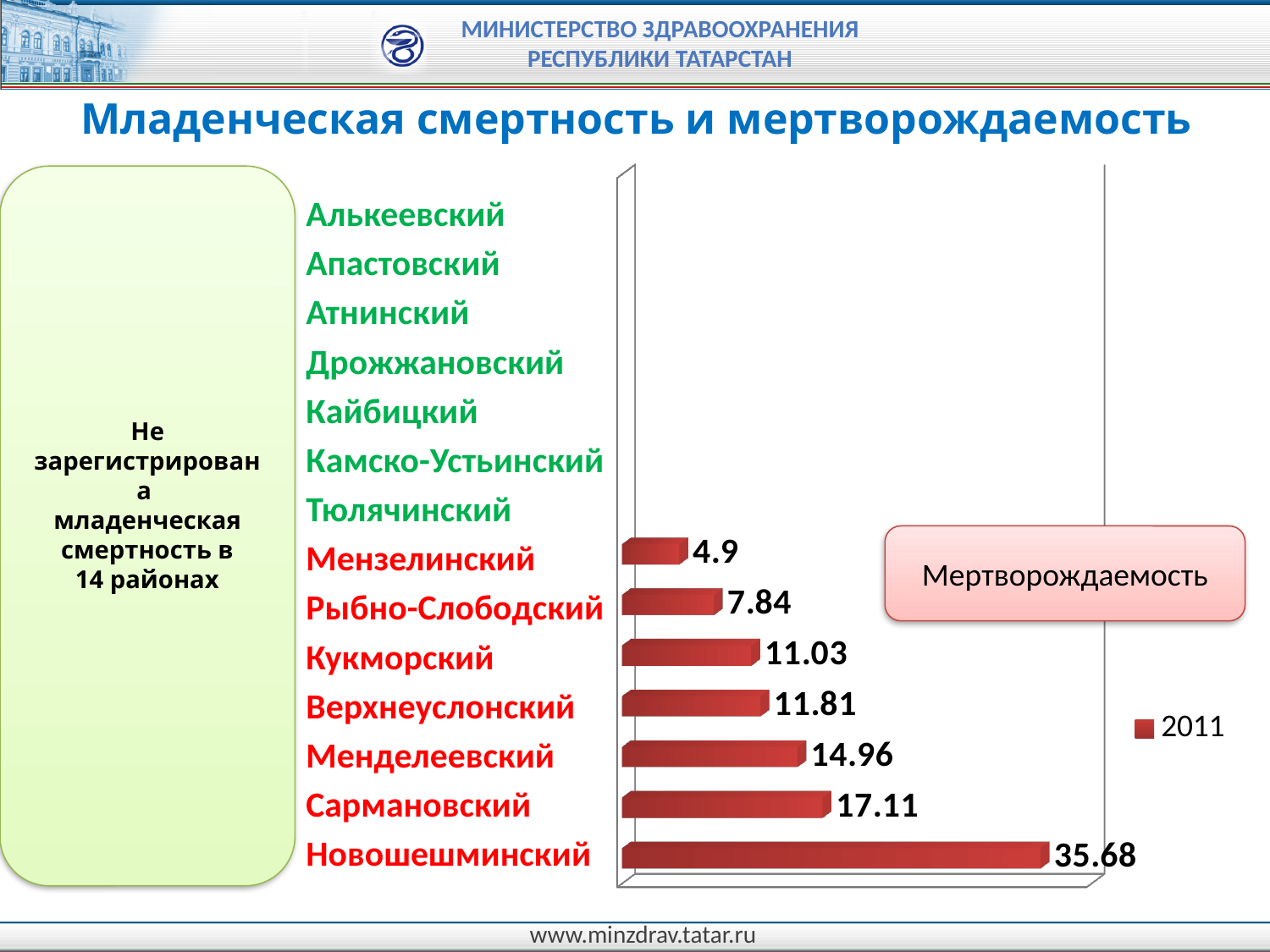
Among the districts with a plotted bar, which has the lowest value? Мензелинский How many series does the legend list? 1 What is the value for Менделеевский? 14.96 Which district has the highest value? Новошешминский What is the value for Мензелинский? 4.9 What is the value for Новошешминский? 35.68 What year does the legend entry show? 2011 What is the difference between the values for Сармановский and Рыбно-Слободский? 9.27 How many districts have a bar plotted in the chart? 7 Which is larger, the value for Верхнеуслонский or the value for Менделеевский? Менделеевский What is the value for Кукморский? 11.03 What kind of chart is shown? Bar chart